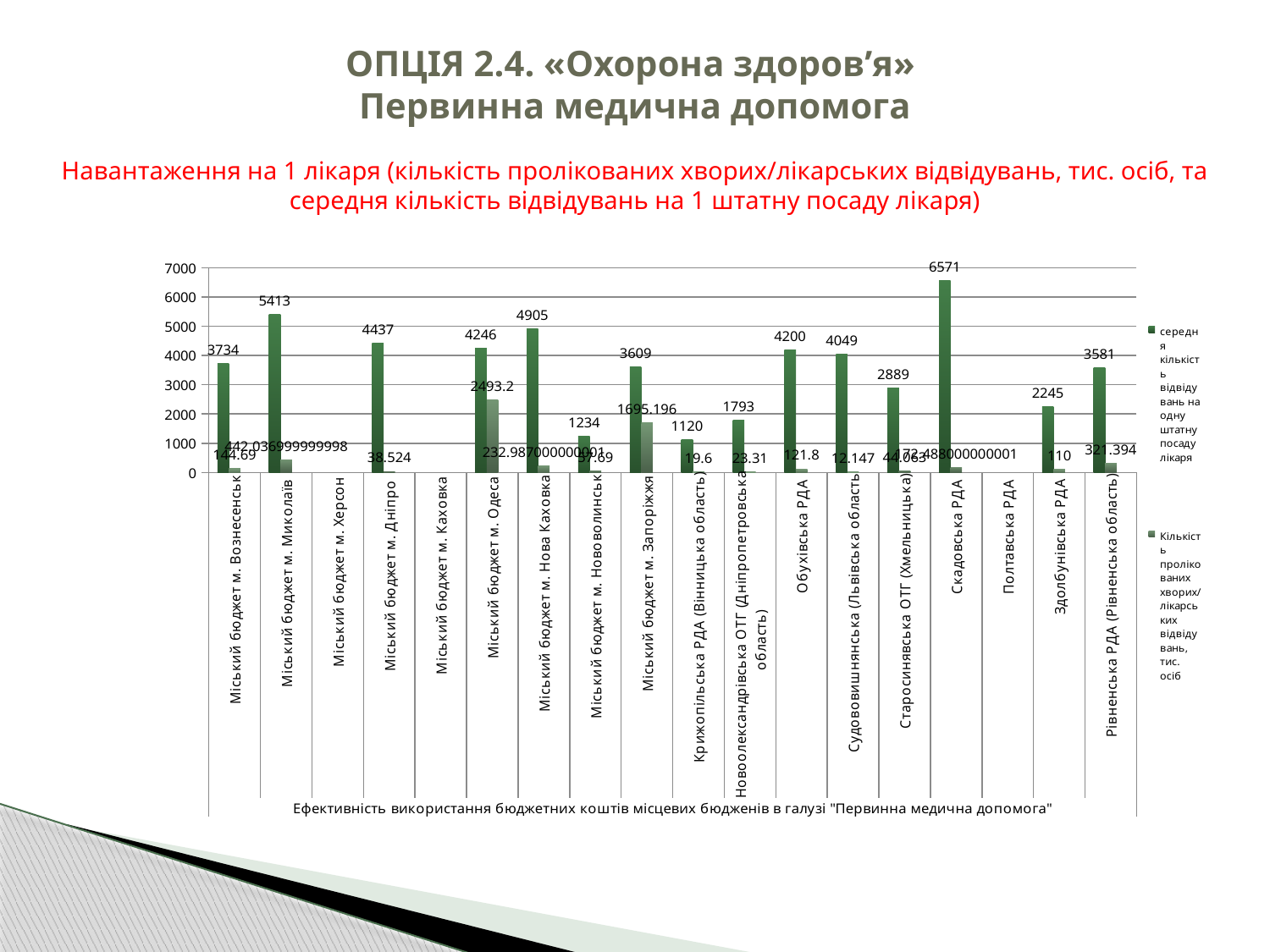
How many series does the chart legend list? 2 What is the number of treated patients/doctor visits (тис. осіб) for Здолбунівська РДА? 110 What is the number of treated patients/doctor visits (тис. осіб) for Міський бюджет м. Одеса? 2493.2 What is the difference in average visits per staff doctor position between Міський бюджет м. Миколаїв and Міський бюджет м. Вознесенськ? 1679 What is the difference in average visits per staff doctor position between Скадовська РДА and Міський бюджет м. Миколаїв? 1158 Among the categories with plotted values, which has the lowest average number of visits per staff doctor position? Крижопільська РДА (Вінницька область) How many categories are shown along the x axis of the chart? 18 What is the average number of visits per staff doctor position (середня кількість відвідувань) for Скадовська РДА? 6571 What is the average number of visits per staff doctor position for Міський бюджет м. Миколаїв? 5413 Which category has the highest average number of visits per staff doctor position? Скадовська РДА Which has a higher average number of visits per staff doctor position: Міський бюджет м. Дніпро or Обухівська РДА? Міський бюджет м. Дніпро What kind of chart is shown on the slide? bar chart